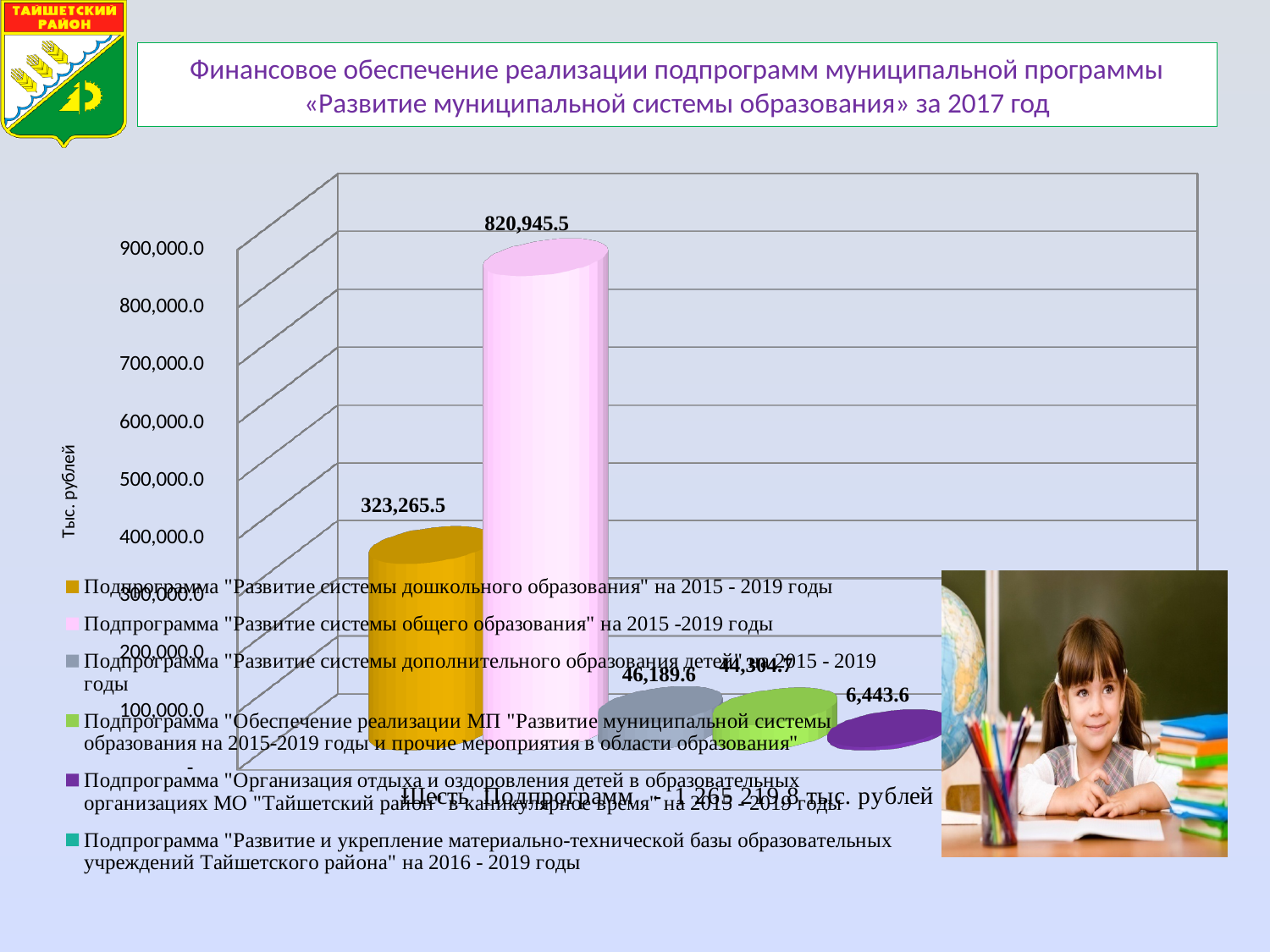
Is the value for the preschool education subprogram greater or less than 400,000.0? less Which is larger: the value for the preschool education subprogram or the value for the additional education subprogram? Preschool education subprogram (323,265.5) What is the value for the subprogram "Развитие системы общего образования" на 2015-2019 годы? 820,945.5 Which subprogram has the highest value on the chart? Подпрограмма "Развитие системы общего образования" на 2015-2019 годы Is the value for the general education subprogram greater or less than 800,000.0? greater What kind of chart is shown on the slide? Bar chart How many series does the legend list? 6 What is the label on the vertical axis of the chart? Тыс. рублей What is the difference between the value for the general education subprogram and the value for the preschool education subprogram? 497,680.0 What is the value for the subprogram "Развитие системы дошкольного образования" на 2015-2019 годы? 323,265.5 What is the value for the subprogram "Развитие системы дополнительного образования детей" на 2015-2019 годы? 46,189.6 What is the value for the subprogram "Организация отдыха и оздоровления детей в образовательных организациях МО "Тайшетский район" в каникулярное время"? 6,443.6